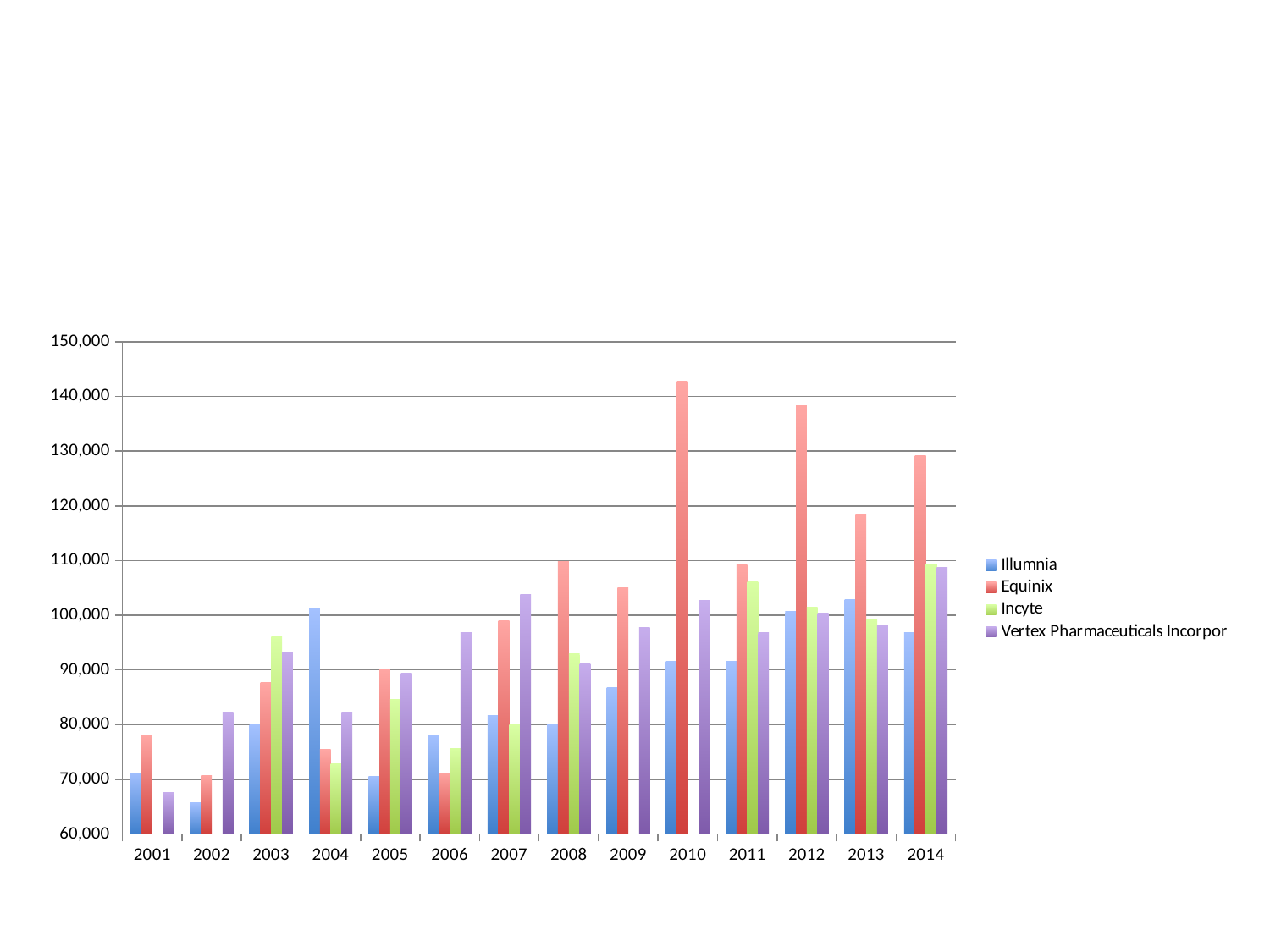
Is the value for Illumnia in 2004 greater or less than 90,000? greater In which year is the Equinix bar highest? 2010 Which colour represents Equinix in the legend? red Is the value for Incyte in 2014 greater or less than 100,000? greater What kind of chart is shown on the slide? bar chart Is the value for Vertex Pharmaceuticals Incorpor in 2001 greater or less than 70,000? less In 2003, which is larger: Incyte or Illumnia? Incyte How many series does the legend list? 4 How many years are shown along the x axis? 14 In which year is the Illumnia bar lowest? 2002 In 2012, which is larger: Equinix or Illumnia? Equinix